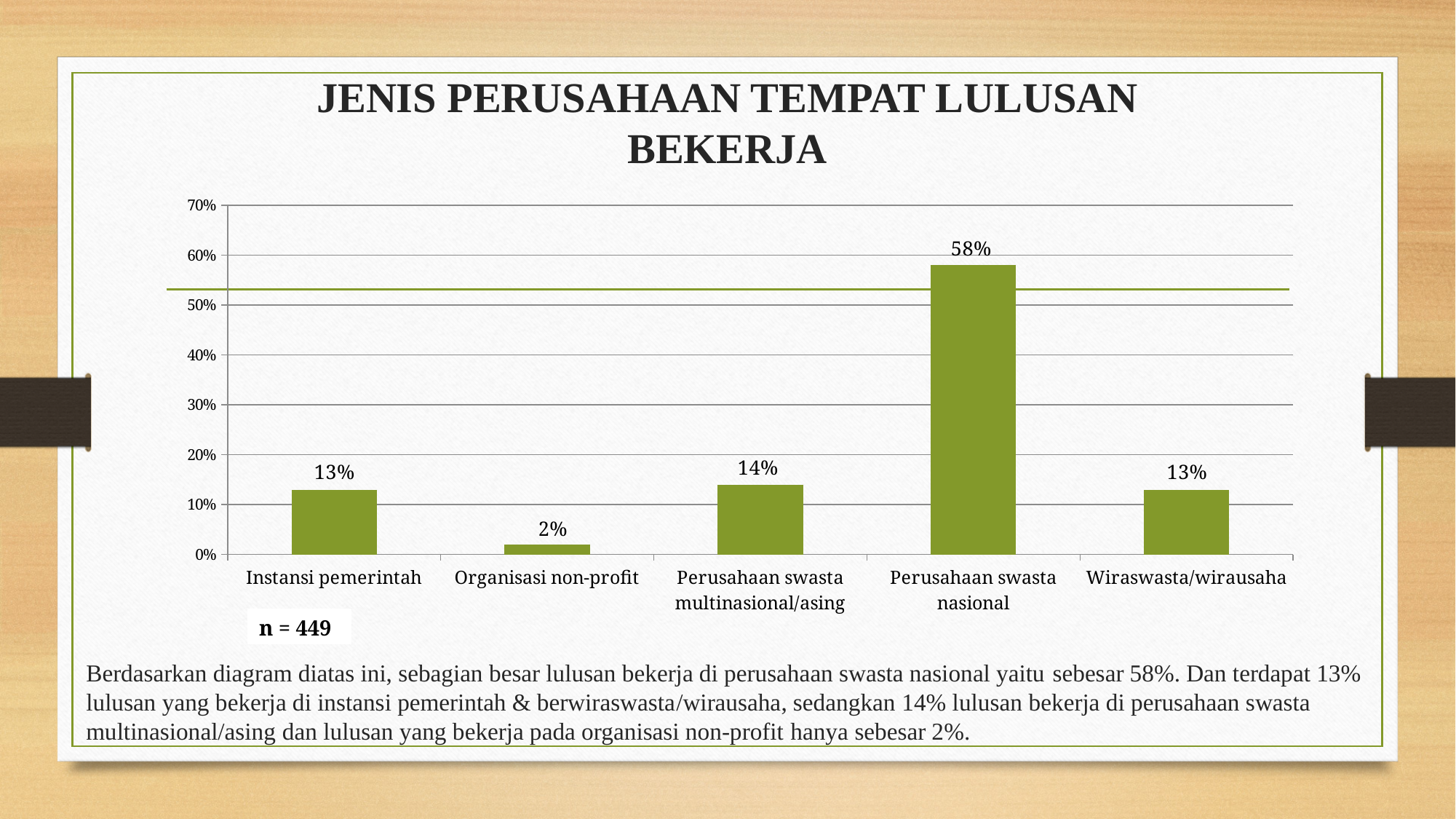
Which is larger, the value for Perusahaan swasta multinasional/asing or the value for Organisasi non-profit? Perusahaan swasta multinasional/asing How many categories are shown on the x axis? 5 What is the difference between the values for Perusahaan swasta nasional and Perusahaan swasta multinasional/asing? 44% What is the value for Organisasi non-profit? 2% What is the value for Instansi pemerintah? 13% What is the value for Perusahaan swasta multinasional/asing? 14% Which category has the highest value? Perusahaan swasta nasional What is the sample size (n) shown below the chart? n = 449 What is the value for Perusahaan swasta nasional? 58% What kind of chart is shown on the slide? bar chart Is the value for Perusahaan swasta nasional greater or less than 50%? greater Which category has the lowest value? Organisasi non-profit